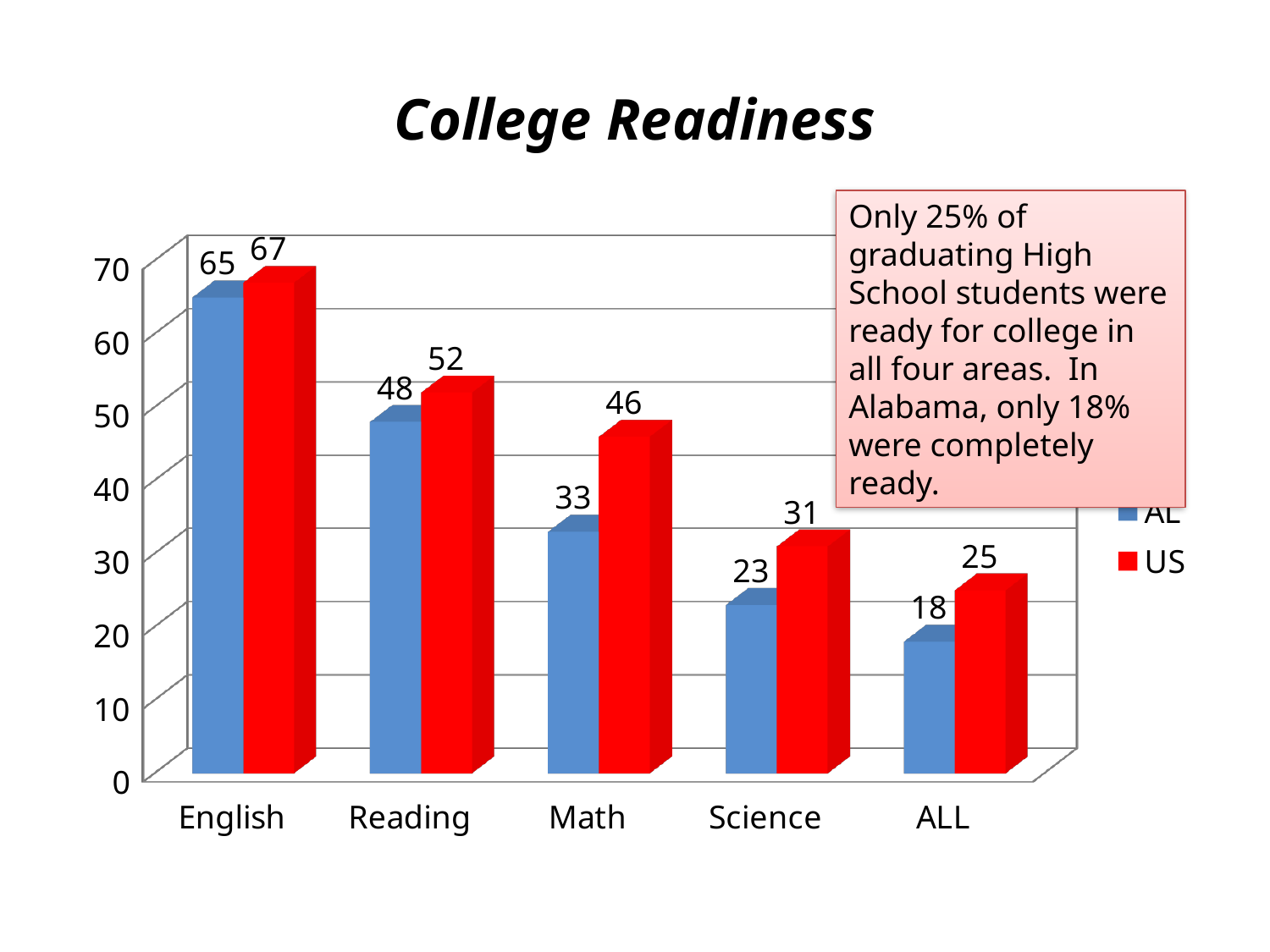
What is the US value for Science? 31 What is the AL value for Math? 33 Which is larger, the AL value for Reading or the US value for Reading? US What kind of chart is shown? bar chart What is the title of the chart? College Readiness Which category has the lowest AL value? ALL How many series does the legend list? 2 Which category has the highest US value? English Is the US value for Math greater or less than 40? greater What is the AL value for ALL? 18 What is the difference between the US and AL values for Math? 13 How many categories are shown on the x axis? 5